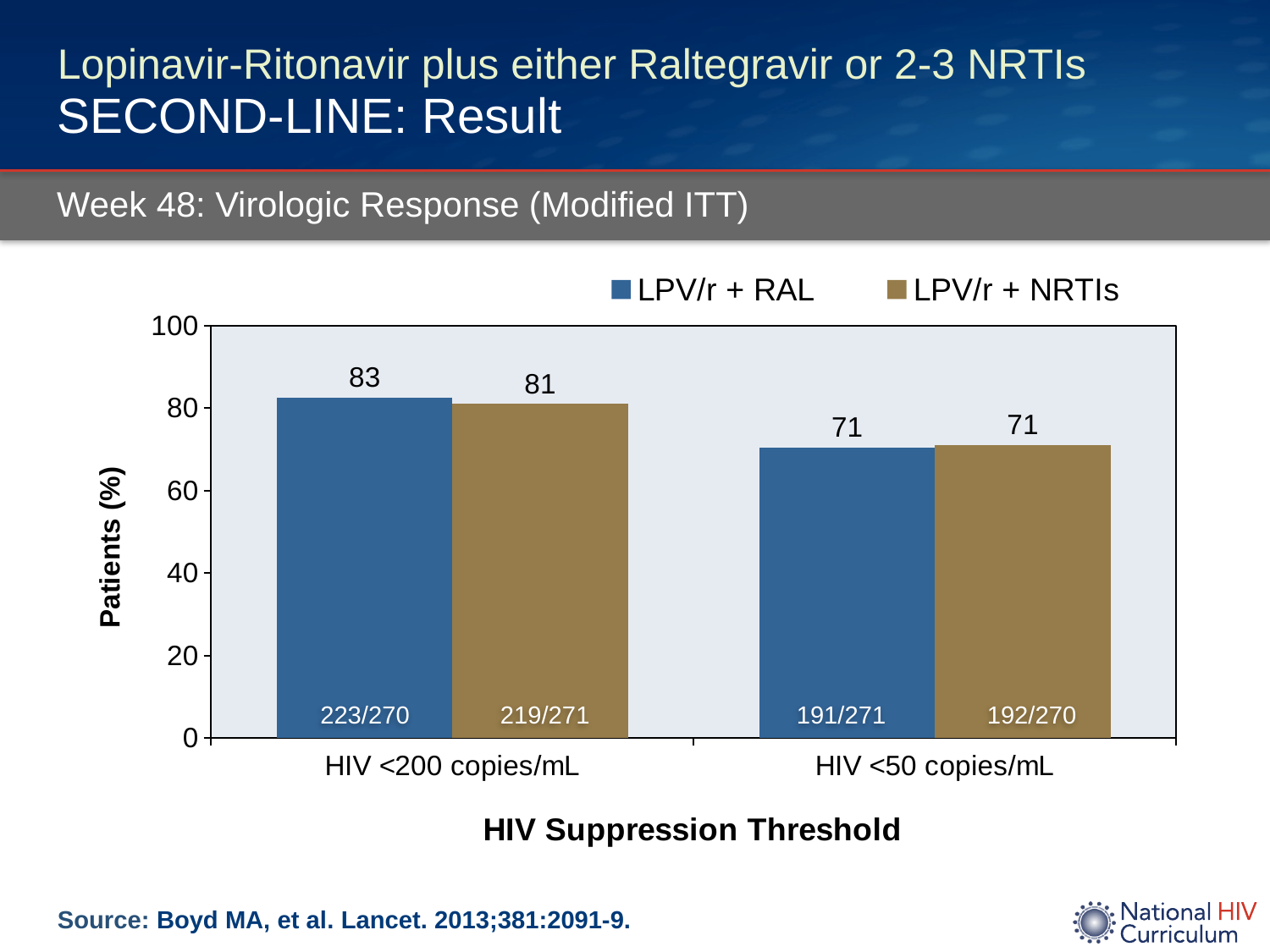
What fraction is printed inside the LPV/r + NRTIs bar at HIV <50 copies/mL? 192/270 What is the difference between the LPV/r + RAL and LPV/r + NRTIs values at HIV <200 copies/mL? 2 What is the value for LPV/r + RAL at HIV <200 copies/mL? 83 What kind of chart is shown on the slide? Bar chart What is the value for LPV/r + RAL at HIV <50 copies/mL? 71 Which series has the higher value at HIV <200 copies/mL, LPV/r + RAL or LPV/r + NRTIs? LPV/r + RAL What is the value for LPV/r + NRTIs at HIV <200 copies/mL? 81 What is the value for LPV/r + NRTIs at HIV <50 copies/mL? 71 How many categories are shown on the x axis? 2 What is the label of the y axis? Patients (%) How many series does the legend list? 2 What is the difference between the LPV/r + RAL values at HIV <200 copies/mL and HIV <50 copies/mL? 12